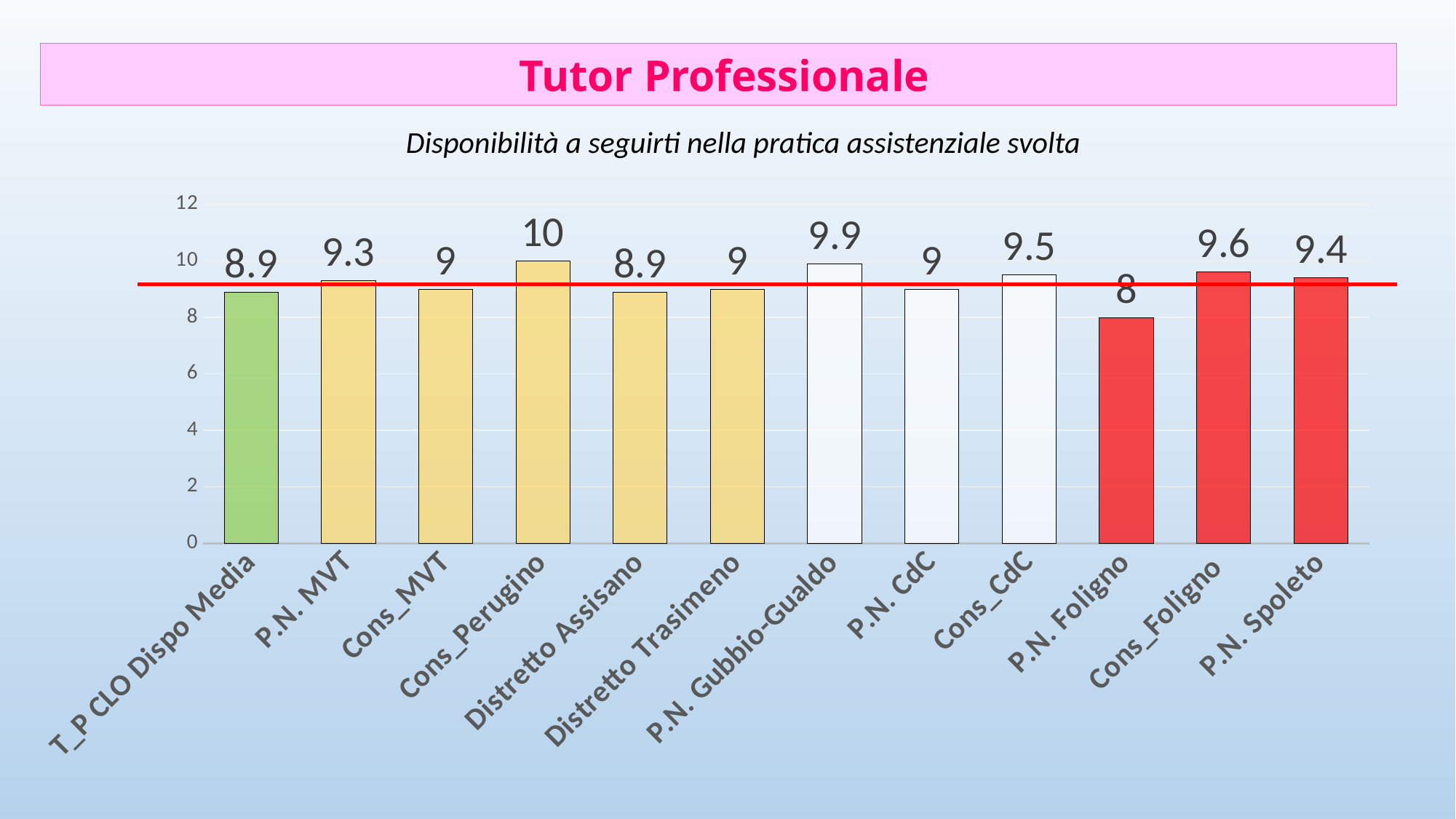
How many categories are shown on the x axis? 12 What is the value for P.N. Foligno? 8 What is the value for P.N. Gubbio-Gualdo? 9.9 What is the value for T_P CLO Dispo Media? 8.9 What kind of chart is shown on the slide? bar chart Is the value for P.N. Foligno greater or less than 10? less Which category has the highest value? Cons_Perugino What is the difference between the values for Cons_Perugino and P.N. Foligno? 2 What is the subtitle shown above the chart? Disponibilità a seguirti nella pratica assistenziale svolta Which category has the lowest value? P.N. Foligno Which is larger, the value for Cons_Foligno or the value for P.N. Spoleto? Cons_Foligno What is the value for Cons_Perugino? 10